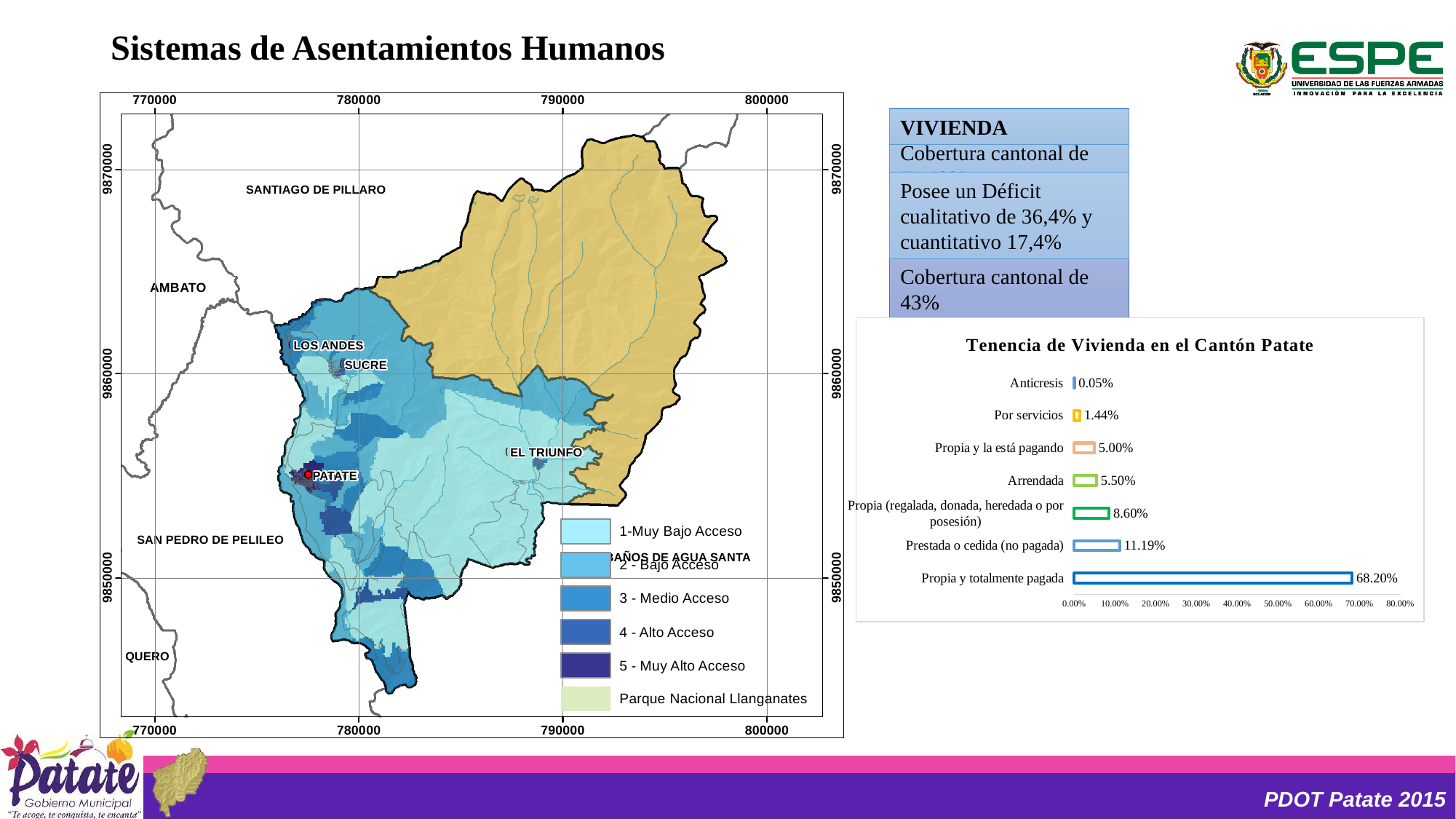
Which category has the lowest value in the Tenencia de Vivienda en el Cantón Patate chart? Anticresis In the Tenencia de Vivienda chart, is the value for Propia y totalmente pagada greater or less than 60.00%? greater Which category has the highest value in the Tenencia de Vivienda en el Cantón Patate chart? Propia y totalmente pagada What is the value for Anticresis in the Tenencia de Vivienda chart? 0.05% In the Tenencia de Vivienda chart, which is larger: Arrendada or Propia y la está pagando? Arrendada What is the value for Prestada o cedida (no pagada) in the Tenencia de Vivienda chart? 11.19% What is the value for Por servicios in the Tenencia de Vivienda chart? 1.44% What is the value for Arrendada in the Tenencia de Vivienda chart? 5.50% What is the value for Propia y totalmente pagada in the Tenencia de Vivienda en el Cantón Patate chart? 68.20% How many categories are shown in the Tenencia de Vivienda en el Cantón Patate chart? 7 In the Tenencia de Vivienda chart, what is the difference between Propia y totalmente pagada and Prestada o cedida (no pagada)? 57.01% What kind of chart is the Tenencia de Vivienda en el Cantón Patate chart? Bar chart